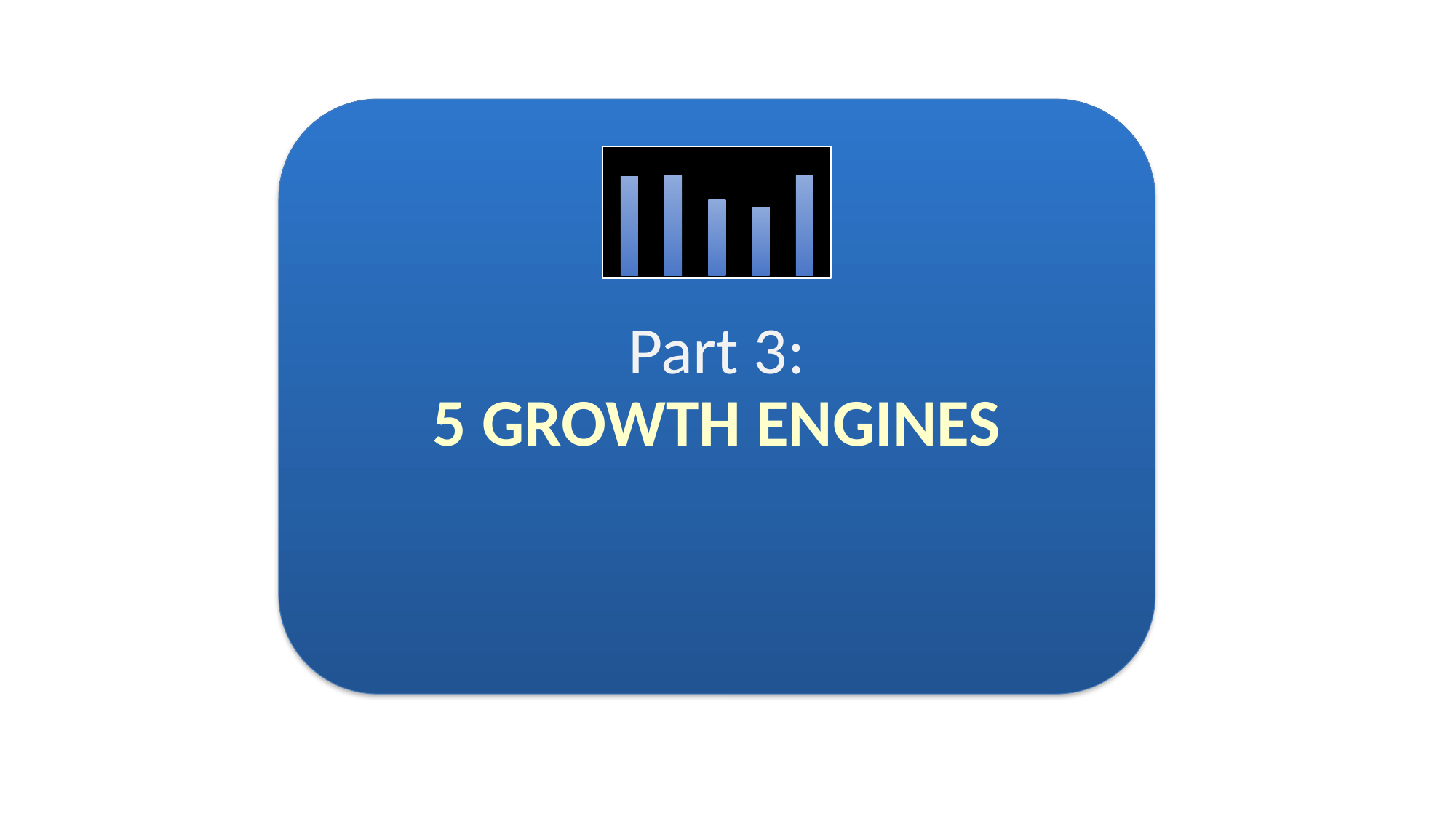
Counting from the left, which bar in the chart icon is the shortest? the fourth bar What colour are the bars in the chart icon on the slide? blue In the chart icon, is the fifth bar from the left taller or shorter than the fourth bar? taller What kind of chart is shown in the icon at the top of the slide? bar chart What colour is the background of the chart icon on the slide? black How many bars does the chart icon on the slide show? 5 In the chart icon, is the third bar from the left taller or shorter than the fourth bar? taller